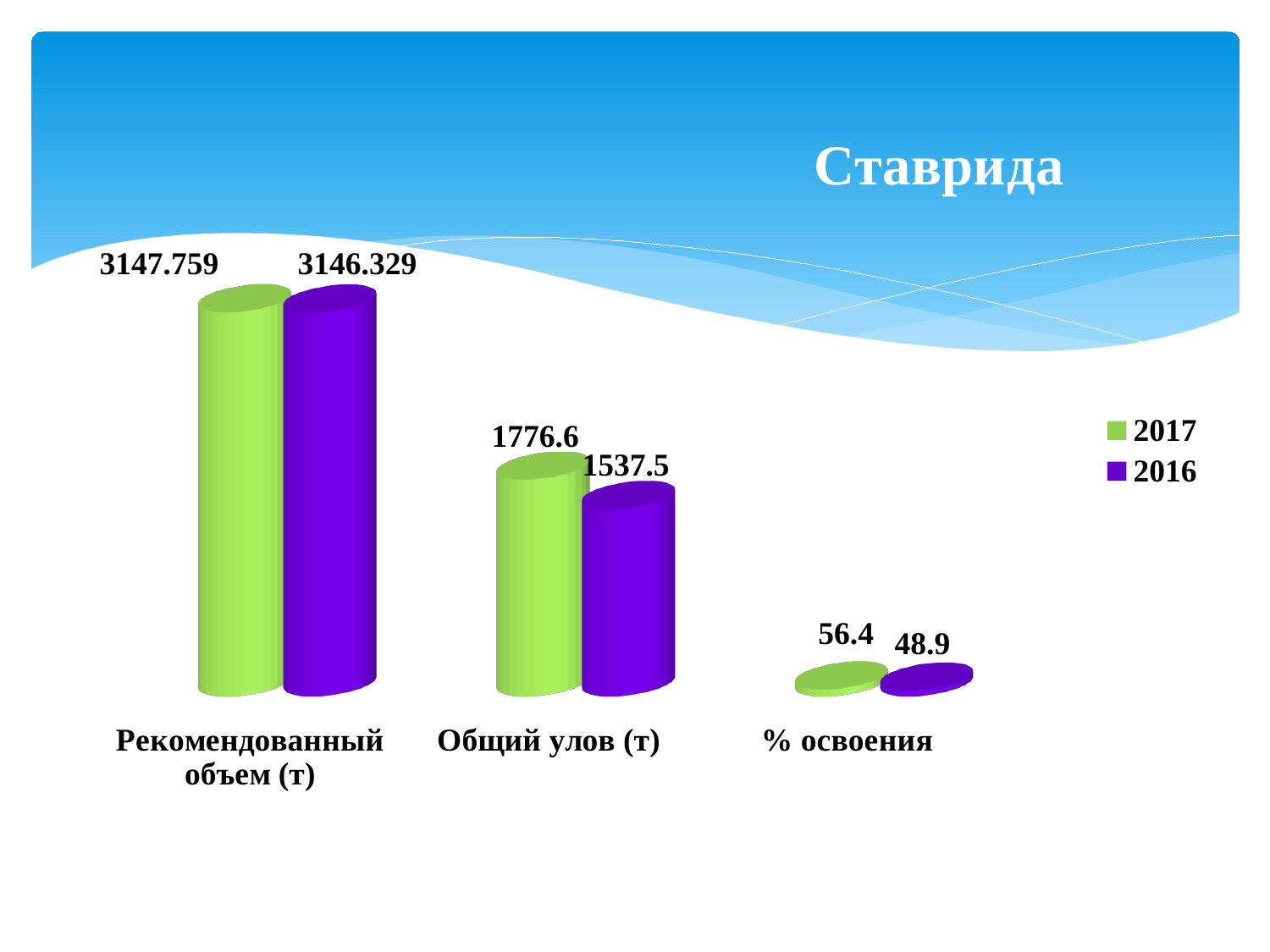
How many categories are shown on the x axis? 3 What is the value for 2016 in the % освоения category? 48.9 What is the difference between the 2017 and 2016 values in the Общий улов (т) category? 239.1 What is the value for 2016 in the Общий улов (т) category? 1537.5 How many series does the legend list? 2 What is the value for 2017 in the Рекомендованный объем (т) category? 3147.759 What is the difference between the 2017 and 2016 values in the % освоения category? 7.5 What is the value for 2016 in the Рекомендованный объем (т) category? 3146.329 In the % освоения category, which year has the larger value, 2017 or 2016? 2017 What is the value for 2017 in the Общий улов (т) category? 1776.6 What is the title of the chart? Ставрида Which category has the lowest values for both years? % освоения